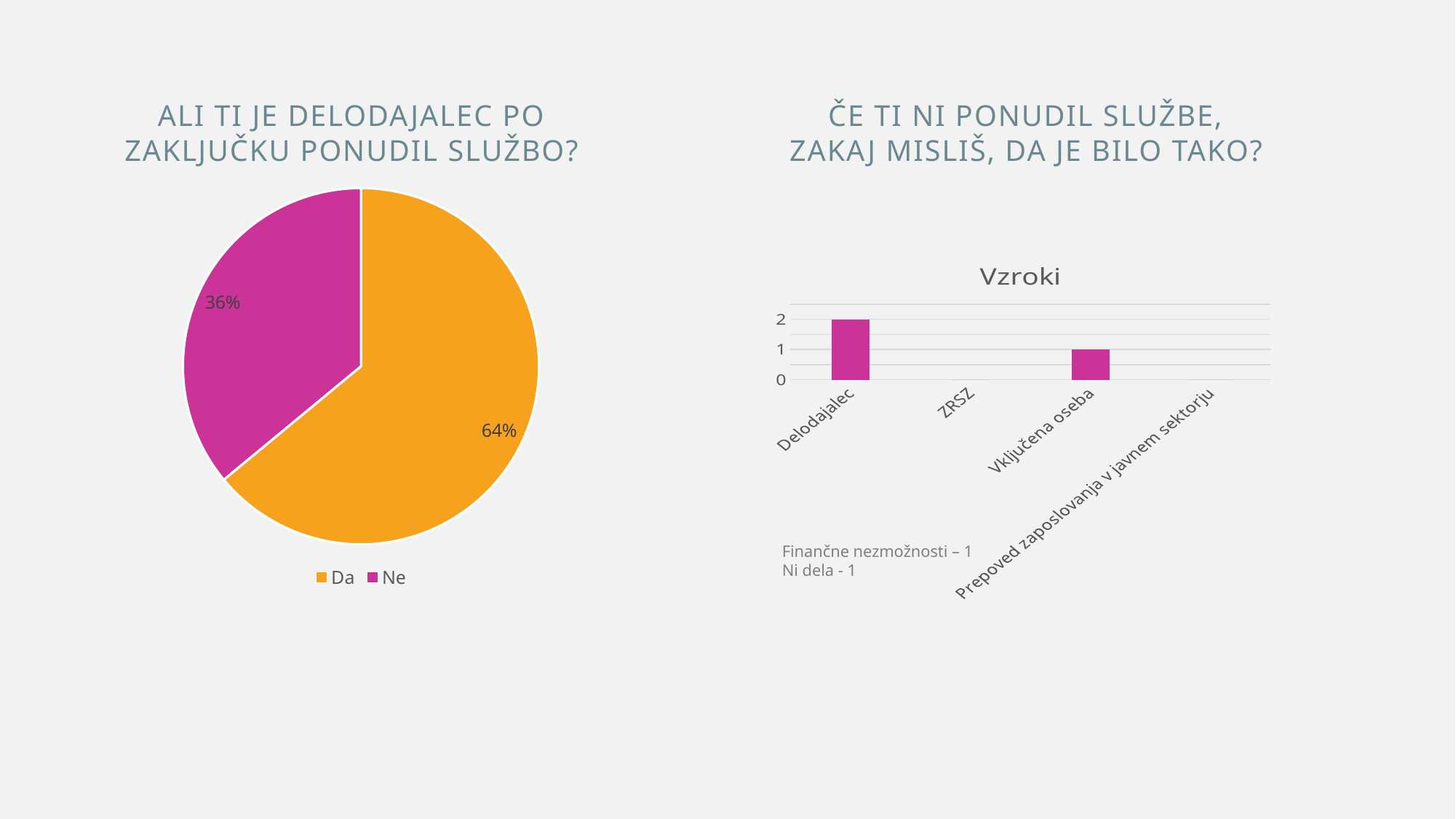
In the pie chart on the left, what colour is the "Ne" slice? Magenta In the "Vzroki" chart, what is the value for "Delodajalec"? 2 In the "Vzroki" chart, what is the value for "Vključena oseba"? 1 In the pie chart on the left, what is the difference in percentage points between the "Da" and "Ne" slices? 28 In the "Vzroki" chart, which category has the highest value? Delodajalec In the pie chart on the left, what share of respondents answered "Ne"? 36% What type of chart is the chart on the left of the slide? Pie chart In the pie chart on the left, which answer has the larger share, "Da" or "Ne"? Da How many categories are shown on the x axis of the "Vzroki" chart? 4 What type of chart is the "Vzroki" chart on the right? Bar chart In the pie chart on the left, what share of respondents answered "Da"? 64% How many entries does the legend of the pie chart on the left list? 2